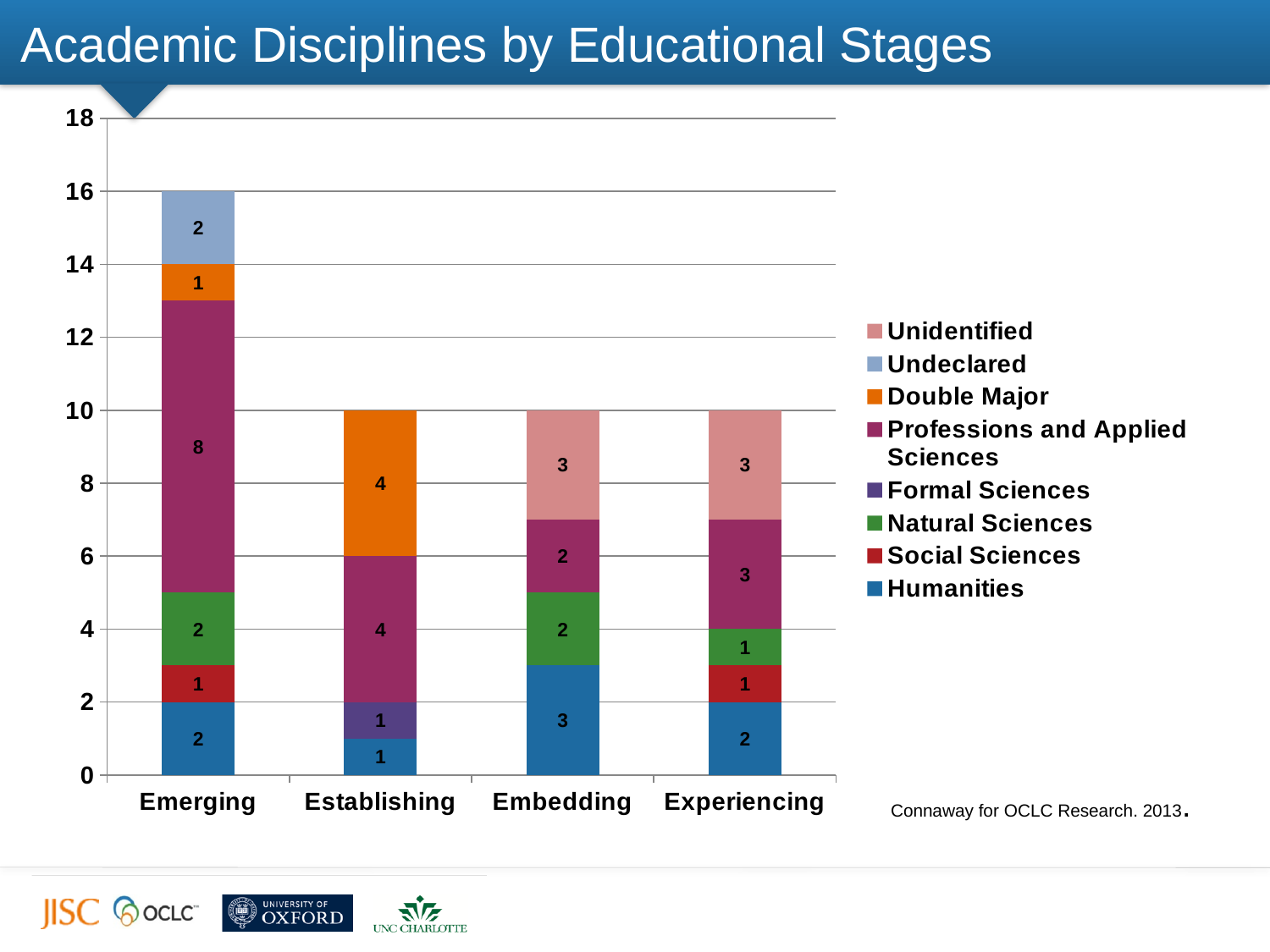
Which is larger: the Humanities value for Embedding or the Humanities value for Establishing? Embedding What is the difference between the Professions and Applied Sciences value in the Emerging stage and in the Experiencing stage? 5 What is the value for Double Major in the Establishing stage? 4 How many educational stages are shown along the x axis? 4 What is the value for Humanities in the Embedding stage? 3 What is the title of the chart? Academic Disciplines by Educational Stages Which educational stage has the highest total bar? Emerging What is the value for Professions and Applied Sciences in the Emerging stage? 8 What is the total of the stacked bar for the Emerging stage? 16 How many series does the legend list? 8 What is the total of the stacked bar for the Experiencing stage? 10 What kind of chart is shown on the slide? Stacked bar chart